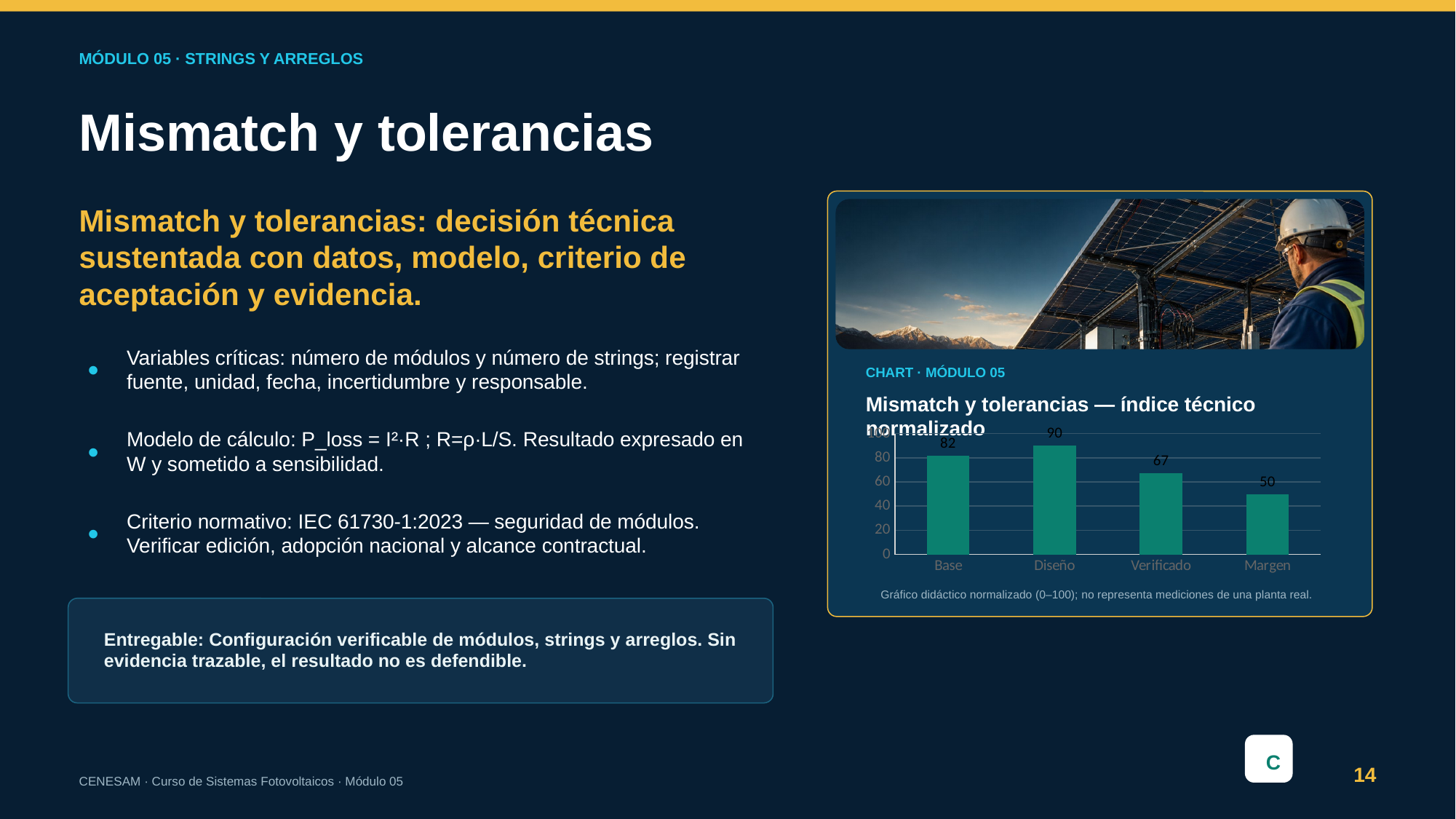
What is the difference between the values for Base and Verificado? 15 What is the value for Diseño? 90 Which is larger, the value for Base or the value for Verificado? Base What is the value for Base? 82 What is the title of the chart? Mismatch y tolerancias — índice técnico normalizado What is the value for Verificado? 67 What is the value for Margen? 50 What kind of chart is shown? Bar chart What is the difference between the values for Diseño and Margen? 40 How many categories are shown on the x axis? 4 Which category has the lowest value? Margen Which category has the highest value? Diseño